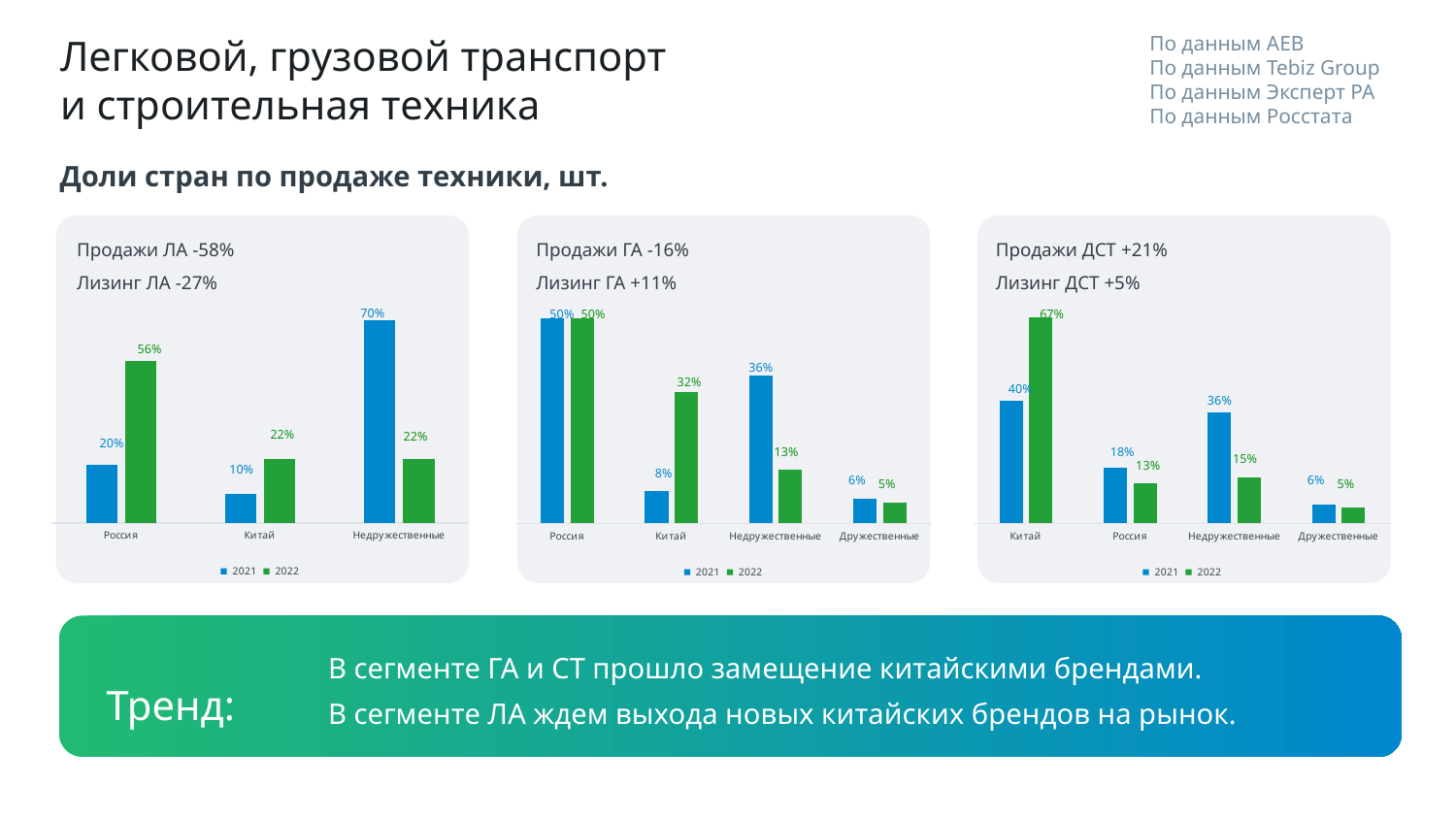
What type of chart is the left chart? Bar chart How many series does the legend of the right chart list? 2 In the left chart, which category has the highest 2021 value? Недружественные In the middle chart, which category has the lowest 2022 value? Дружественные In the middle chart, which is larger for Недружественные: the 2021 value or the 2022 value? 2021 In the middle chart, how many categories are shown on the x axis? 4 In the left chart, what is the 2022 value for Россия? 56% In the right chart, what is the 2022 value for Китай? 67% In the left chart, what is the difference between the 2021 and 2022 values for Китай? 12% In the middle chart, what is the 2022 value for Китай? 32% In the left chart, what is the 2021 value for Недружественные? 70% In the right chart, what is the difference between the 2021 and 2022 values for Недружественные? 21%